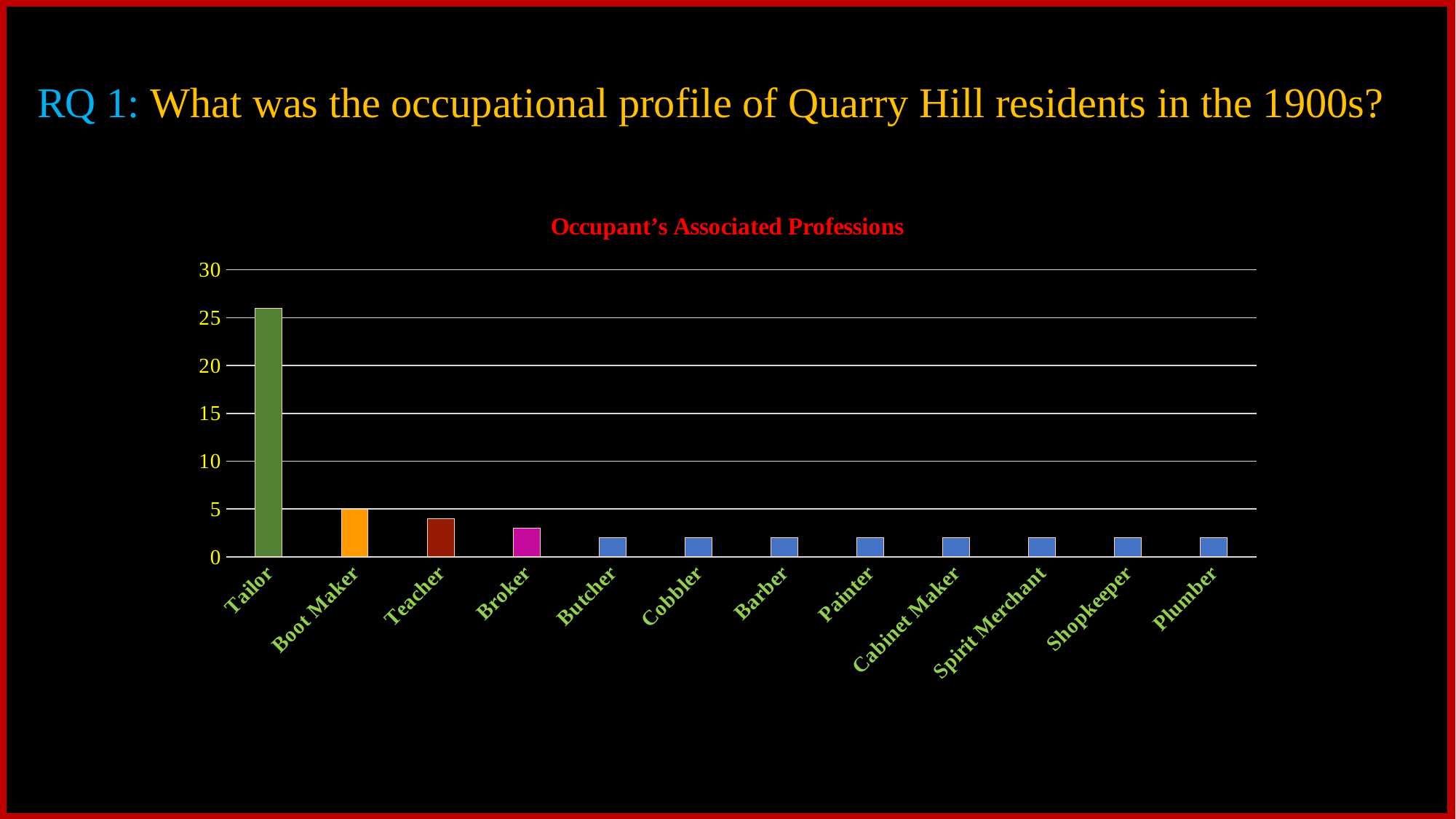
How many professions are shown on the x axis of the chart? 12 What is the value for Boot Maker? 5 What type of chart is shown on the slide? bar chart Which profession has the highest bar in the chart? Tailor Is the value for Teacher greater or less than 5? less What is the title of the chart? Occupant's Associated Professions Which is larger, the value for Boot Maker or the value for Teacher? Boot Maker Which is larger, the value for Broker or the value for Butcher? Broker Is the value for Butcher greater or less than 5? less Is the value for Tailor greater or less than 30? less What colour is the bar for Tailor? green